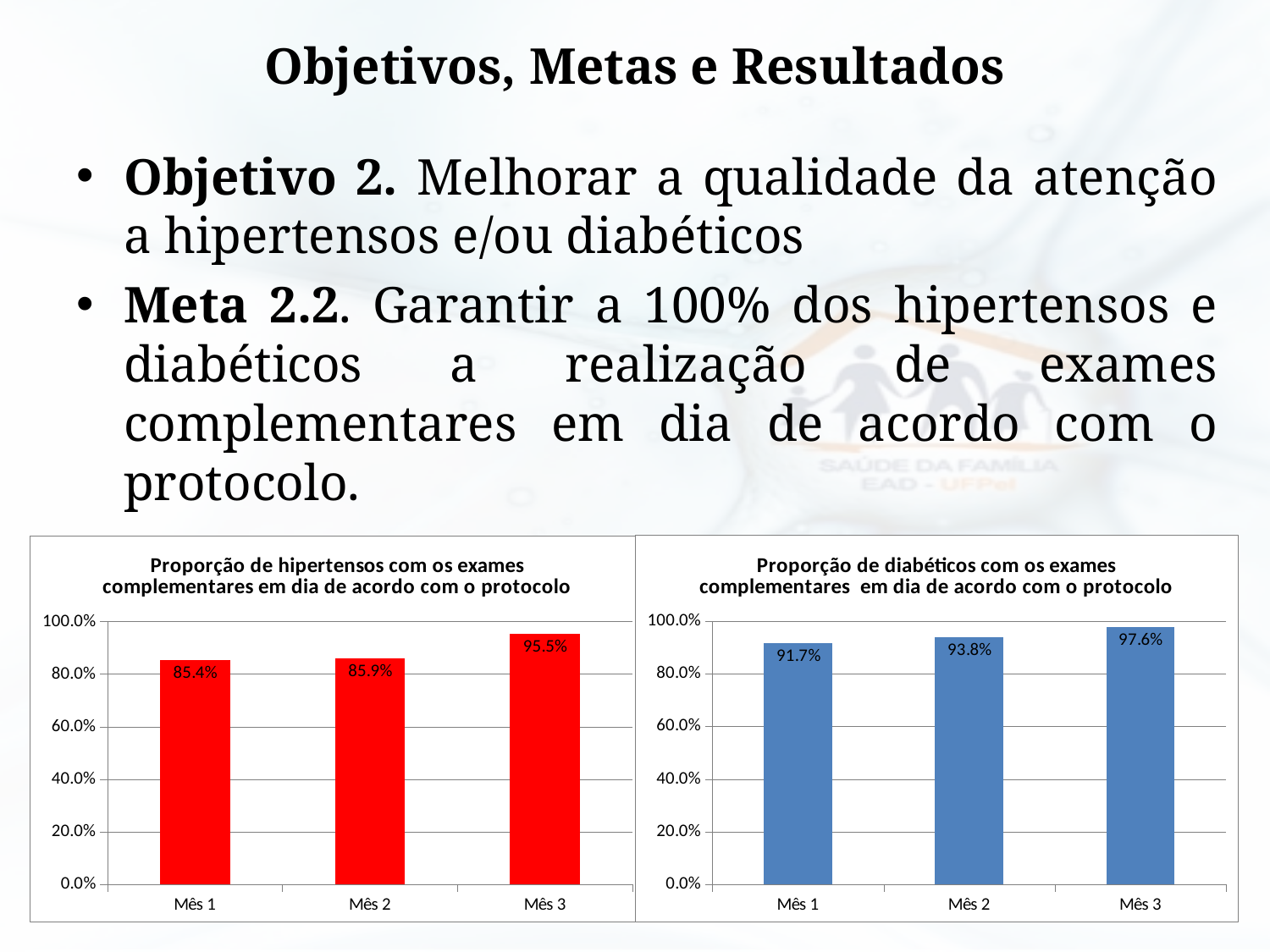
Which is larger: the Mês 1 value in the left chart (hipertensos) or the Mês 1 value in the right chart (diabéticos)? The right chart (diabéticos), 91.7% In the left chart (Proporção de hipertensos com os exames complementares em dia de acordo com o protocolo), what is the value for Mês 1? 85.4% In the left chart (Proporção de hipertensos com os exames complementares em dia de acordo com o protocolo), what is the value for Mês 3? 95.5% In the left chart (Proporção de hipertensos com os exames complementares em dia de acordo com o protocolo), which month has the highest value? Mês 3 In the left chart (Proporção de hipertensos com os exames complementares em dia de acordo com o protocolo), is the value for Mês 2 greater or less than 80.0%? greater How many months (categories) are shown in the right chart (Proporção de diabéticos com os exames complementares em dia de acordo com o protocolo)? 3 In the right chart (Proporção de diabéticos com os exames complementares em dia de acordo com o protocolo), what is the value for Mês 2? 93.8% In the right chart (Proporção de diabéticos com os exames complementares em dia de acordo com o protocolo), which month has the lowest value? Mês 1 In the left chart (Proporção de hipertensos com os exames complementares em dia de acordo com o protocolo), what is the difference between the values for Mês 3 and Mês 1? 10.1% In the right chart (Proporção de diabéticos com os exames complementares em dia de acordo com o protocolo), what is the value for Mês 3? 97.6% In the left chart (Proporção de hipertensos com os exames complementares em dia de acordo com o protocolo), do the values rise or fall from Mês 1 to Mês 3? rise In the right chart (Proporção de diabéticos com os exames complementares em dia de acordo com o protocolo), what is the difference between the values for Mês 3 and Mês 1? 5.9%